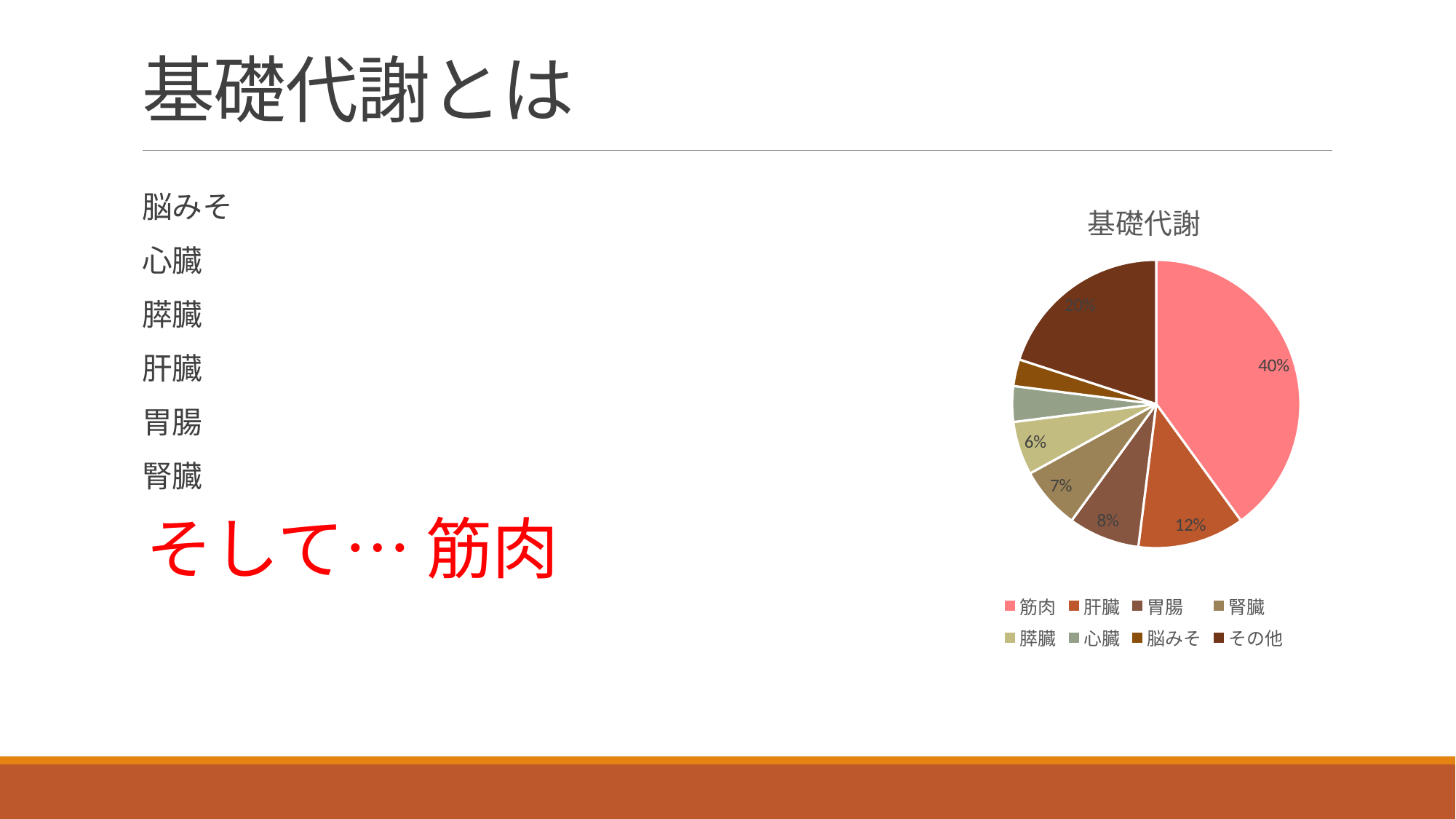
Which category has the largest slice of the pie? 筋肉 What is the value shown for 肝臓? 12% What is the value shown for その他? 20% What kind of chart is shown on the slide? pie chart What is the value shown for 胃腸? 8% How many categories does the legend list? 8 What is the value shown for 膵臓? 6% What is the value shown for 腎臓? 7% What is the title of the chart? 基礎代謝 Which is larger, 胃腸 or 腎臓? 胃腸 How many percentage points larger is 筋肉 than 肝臓? 28 What percentage of the pie does 筋肉 account for? 40%